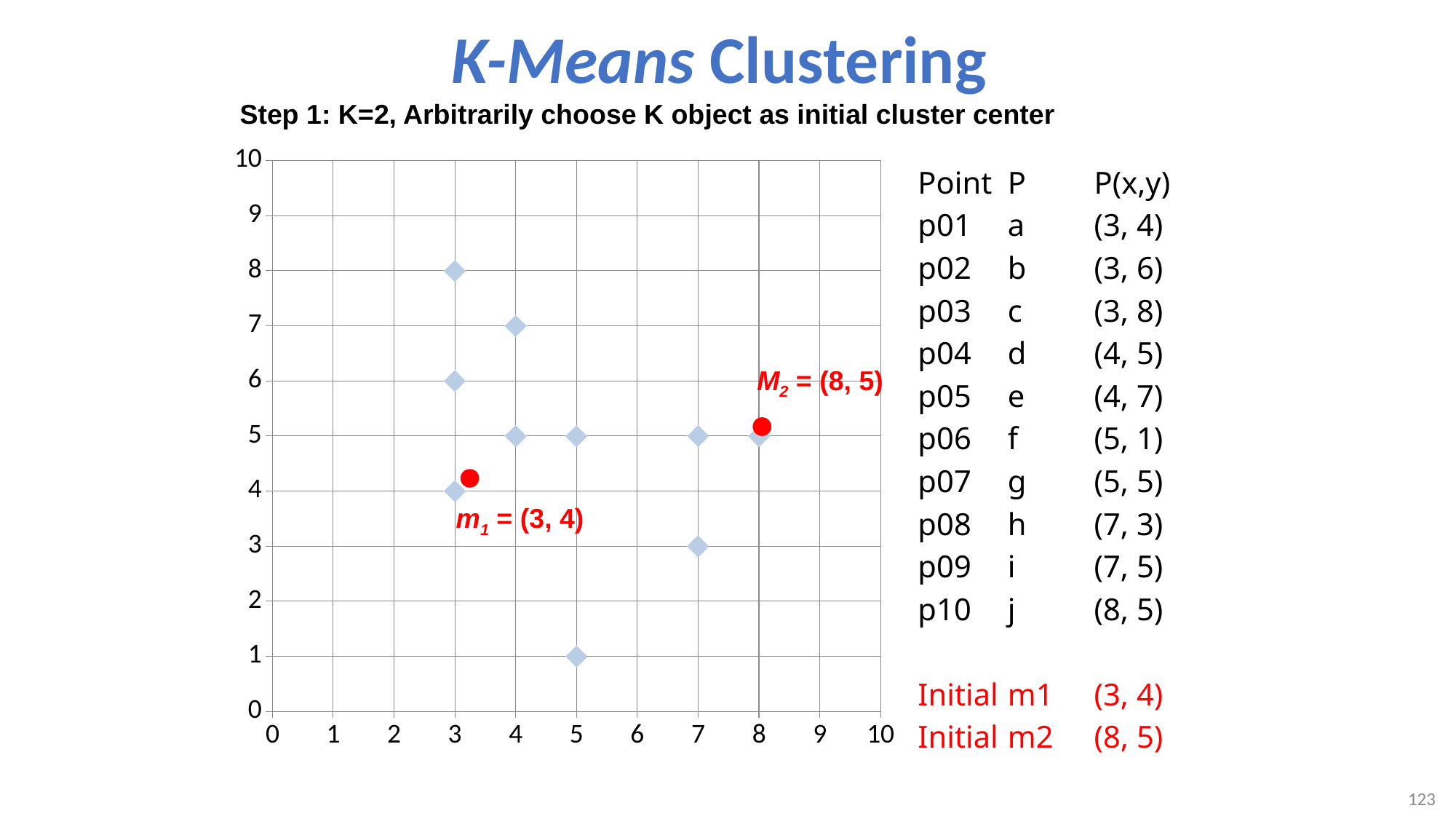
What is the highest y value among the plotted points? 8 What is the maximum value shown on the y axis of the chart? 10 What is the lowest y value among the plotted points? 1 What is the largest x value among the plotted points? 8 Which has the larger y value, the point at x=5 with y=1 or the point at x=7 with y=3? the point at (7, 3) How many plotted points have a y value of 5? 4 What kind of chart is shown on the slide? scatter plot What are the coordinates of the initial cluster center m1 marked on the chart? (3, 4) How many data points (diamond markers) are plotted on the chart? 10 What are the coordinates of the initial cluster center M2 marked on the chart? (8, 5) How many plotted points have an x value of 3? 3 What is the difference in x between the two initial cluster centers m1 and M2? 5